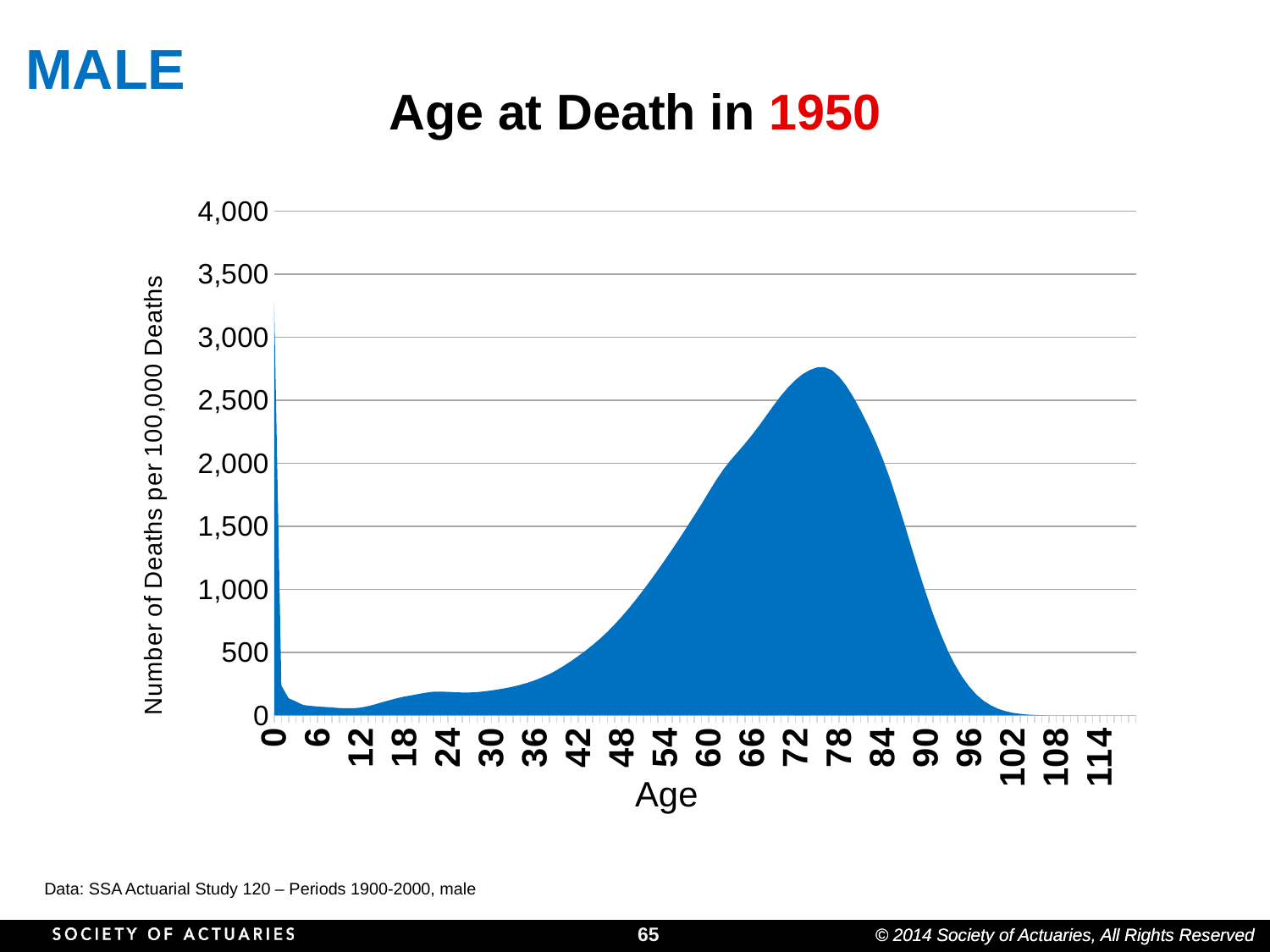
Is the value at age 96 greater or less than 500? less Is the value at age 66 greater or less than 2,000? greater Is the value at age 72 greater or less than 2,500? greater Do the values rise or fall as age increases from 78 to 102? Fall What kind of chart is shown on the slide? Area chart Do the values rise or fall as age increases from 42 to 72? Rise Which has the higher number of deaths, age 0 or age 78? Age 0 What is the label of the vertical axis? Number of Deaths per 100,000 Deaths What is the title of the chart? Age at Death in 1950 Which has the higher number of deaths, age 72 or age 36? Age 72